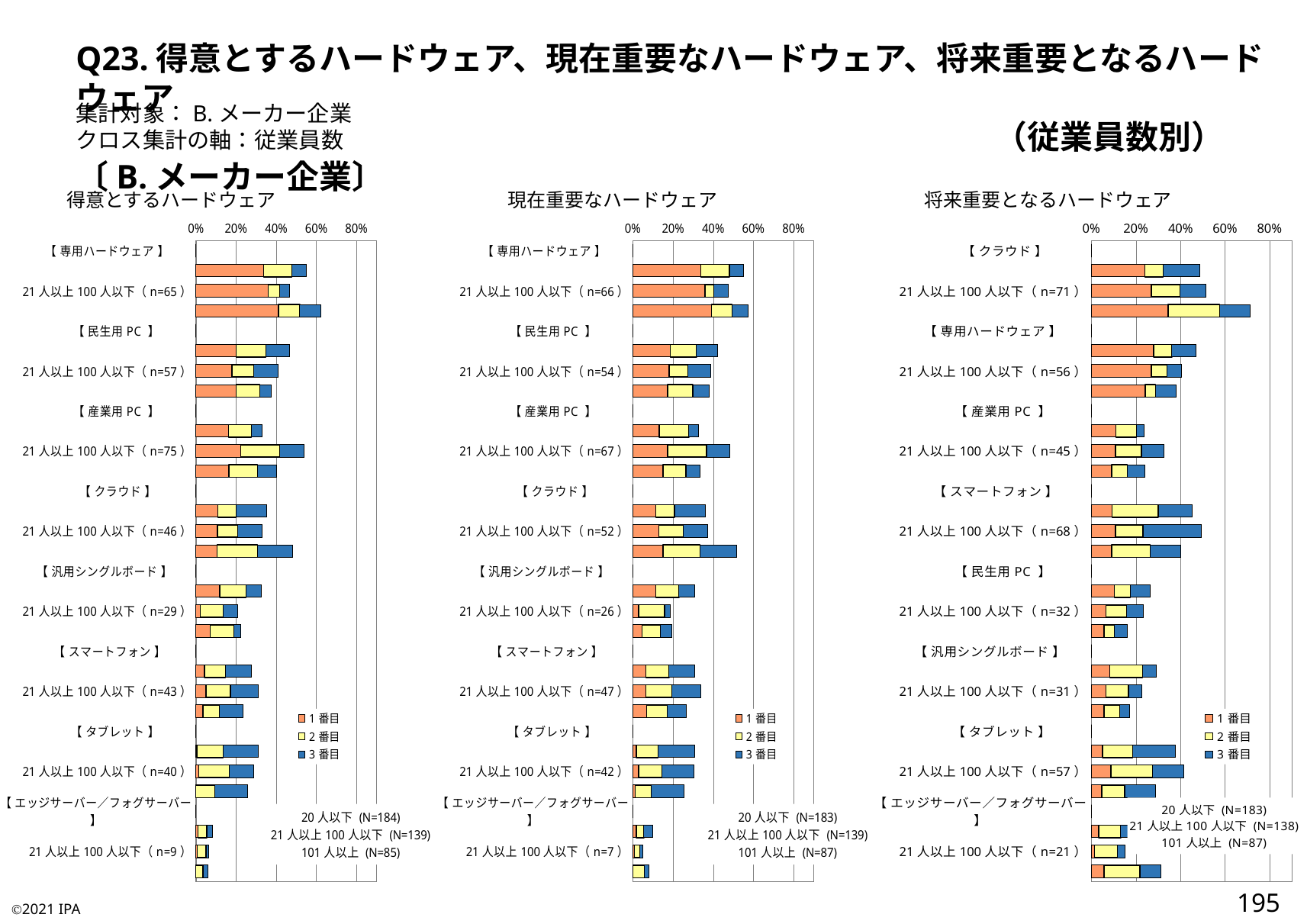
What kind of chart is the left chart titled 得意とするハードウェア? Stacked horizontal bar chart In the middle chart (現在重要なハードウェア), is the total bar for クラウド for the 101人以上 group greater or less than 40%? greater How many series does the legend of the middle chart (現在重要なハードウェア) list? 3 In the right chart (将来重要となるハードウェア), for the 101人以上 group, which has the longer total bar: クラウド or 専用ハードウェア? クラウド In the left chart (得意とするハードウェア), is the total bar for エッジサーバー／フォグサーバー for the 21人以上100人以下 (n=9) group greater or less than 20%? less In the right chart (将来重要となるハードウェア), is the total bar for クラウド for the 101人以上 group greater or less than 60%? greater Which hardware category is listed first in the right chart (将来重要となるハードウェア)? クラウド How many hardware categories are shown in the left chart (得意とするハードウェア)? 8 What are the legend entries of the right chart (将来重要となるハードウェア)? 1番目, 2番目, 3番目 In the right chart (将来重要となるハードウェア), which employee-size group has the longest total bar for クラウド? 101人以上 In the left chart (得意とするハードウェア), what is the N value shown for the 20人以下 group? N=184